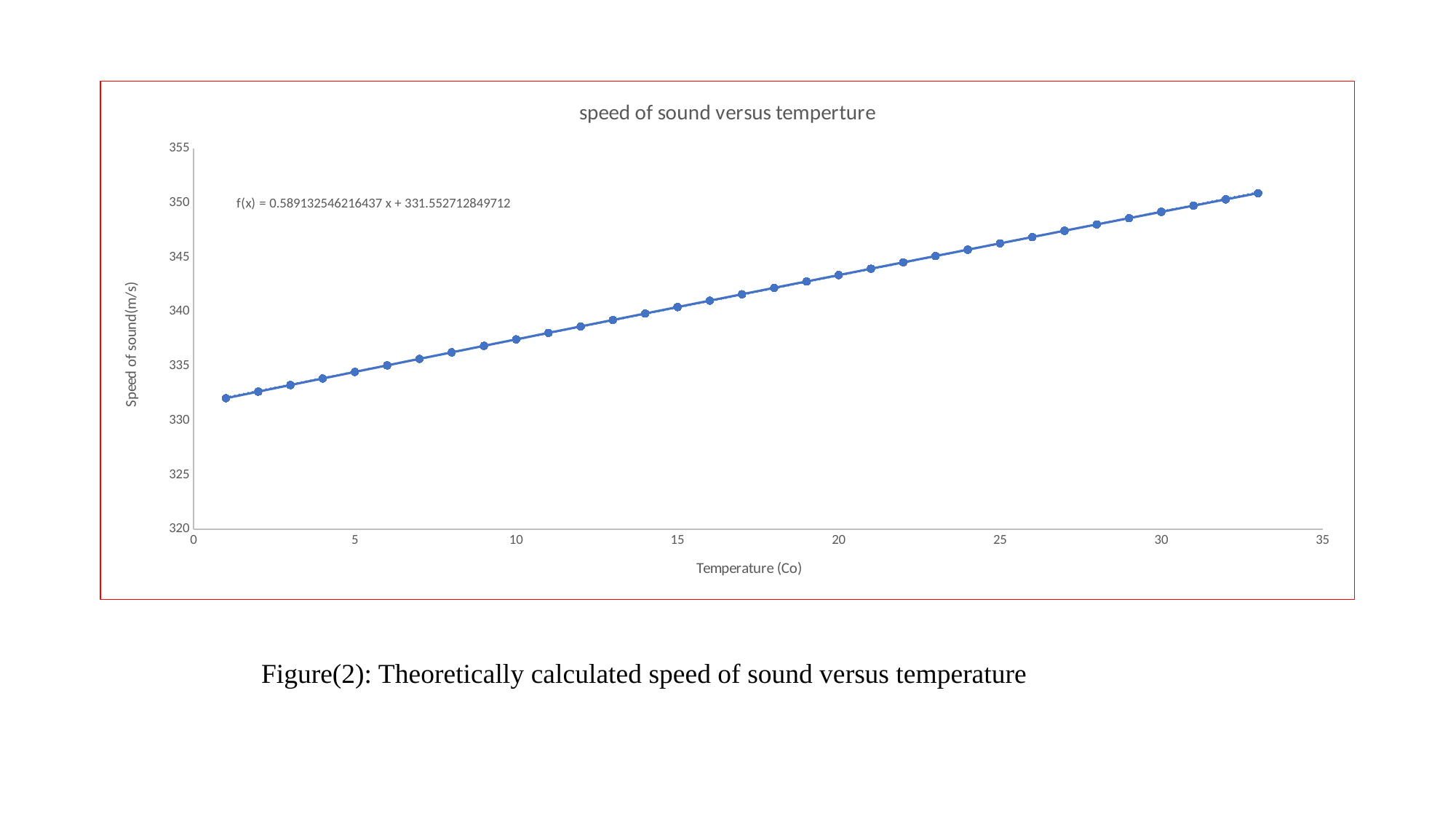
Do the plotted values rise or fall as temperature increases along the x axis? rise What is the label of the y axis? Speed of sound(m/s) At which temperature is the speed of sound lowest? 1 What type of chart is shown on the slide? scatter chart Is the speed of sound at a temperature of 1 greater or less than 335? less At which temperature is the speed of sound highest? 33 Which has a higher speed of sound, a temperature of 25 or a temperature of 15? 25 Is the speed of sound at a temperature of 33 greater or less than 345? greater What is the title of the chart? speed of sound versus temperture Is the speed of sound at a temperature of 20 greater or less than 340? greater How many data points are plotted on the chart? 33